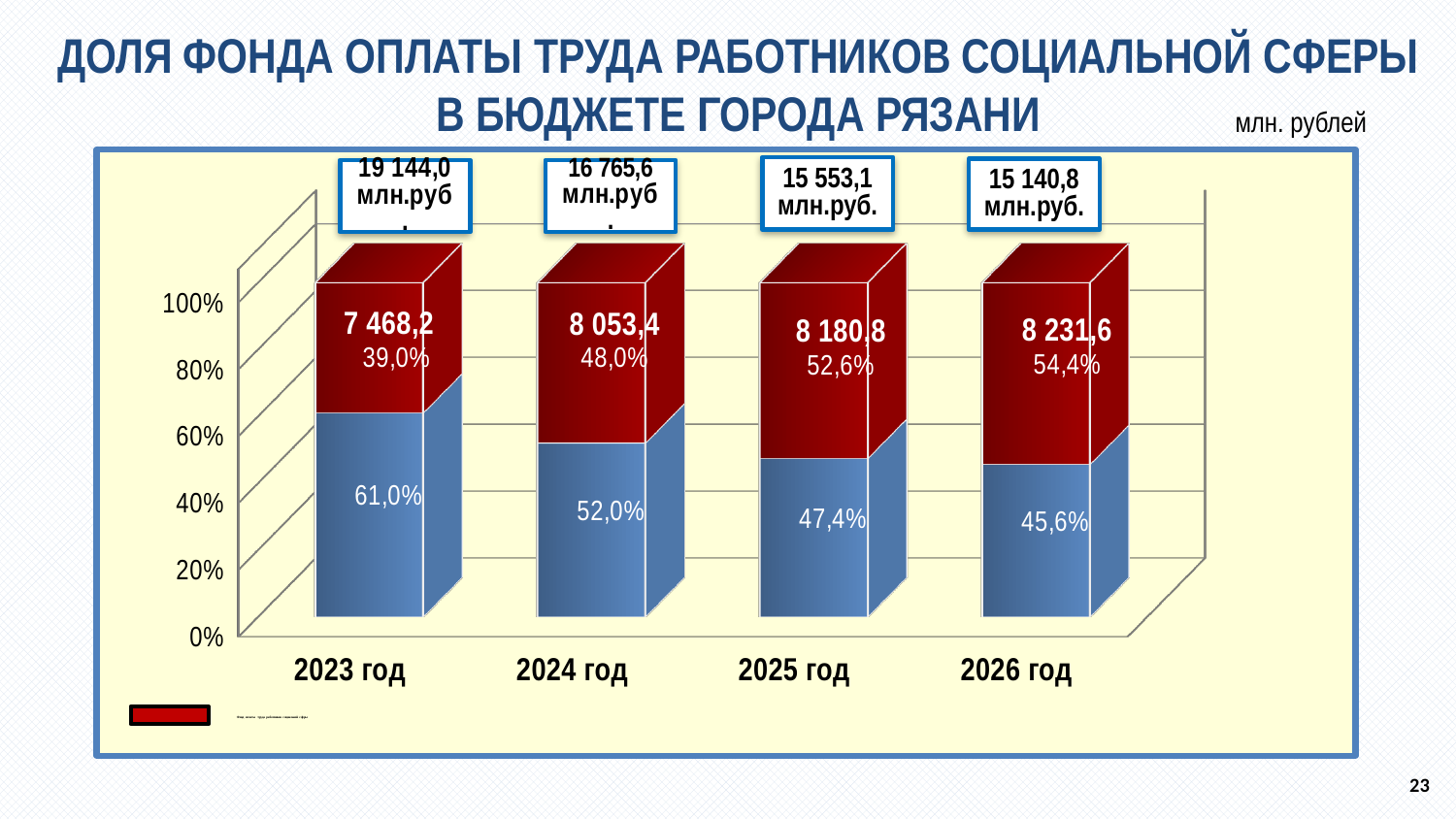
For 2024 год, which segment has the larger percentage, the red one or the blue one? The blue one (52,0%) What percentage is printed in the red segment for 2026 год? 54,4% What total amount is printed above the bar for 2025 год? 15 553,1 млн.руб. Which year has the lowest percentage in the blue segment? 2026 год What value is printed in the red segment for 2023 год? 7 468,2 How many years (categories) are shown on the x axis of the chart? 4 What kind of chart is shown on the slide? Stacked bar chart Which year has the highest percentage in the red segment? 2026 год Does the percentage of the red segment rise or fall from 2023 год to 2026 год? Rises What is the difference between the red segment values for 2026 год (8 231,6) and 2023 год (7 468,2)? 763,4 What percentage is printed in the blue segment for 2025 год? 47,4% What is the difference between the total amounts printed above the bars for 2023 год (19 144,0) and 2026 год (15 140,8)? 4 003,2